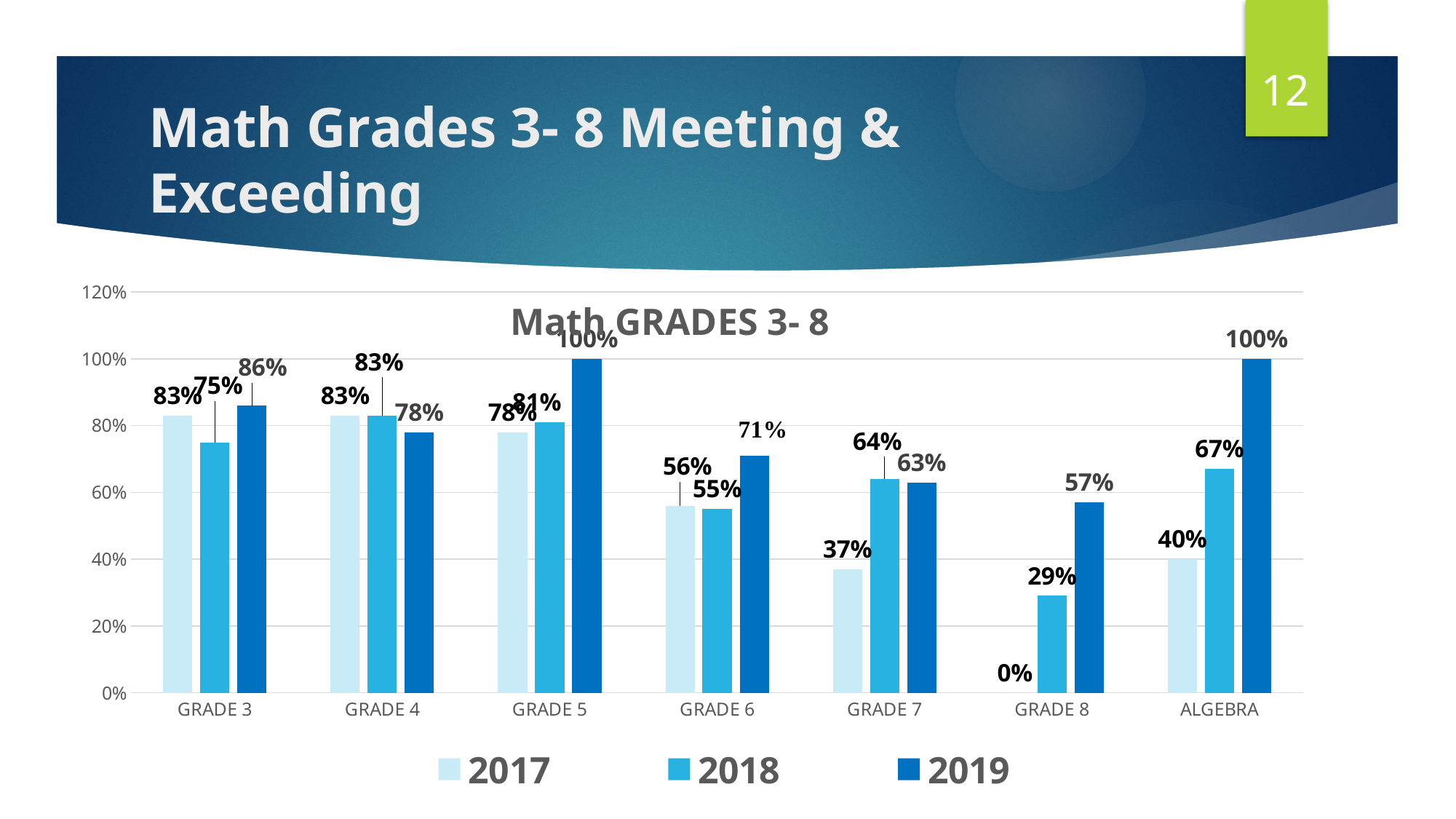
Which is larger for GRADE 3: the 2018 value or the 2019 value? 2019 How many series does the legend list? 3 Which category has the lowest 2017 value? GRADE 8 Which category has the highest 2018 value? GRADE 4 What is the difference between the 2018 and 2017 values for GRADE 7? 27% What is the 2018 value for ALGEBRA? 67% What is the 2019 value for GRADE 8? 57% What kind of chart is shown on the slide? Bar chart What is the 2017 value for GRADE 7? 37% What is the difference between the 2019 and 2017 values for GRADE 8? 57% What is the 2019 value for GRADE 6? 71% How many categories are shown on the x axis? 7